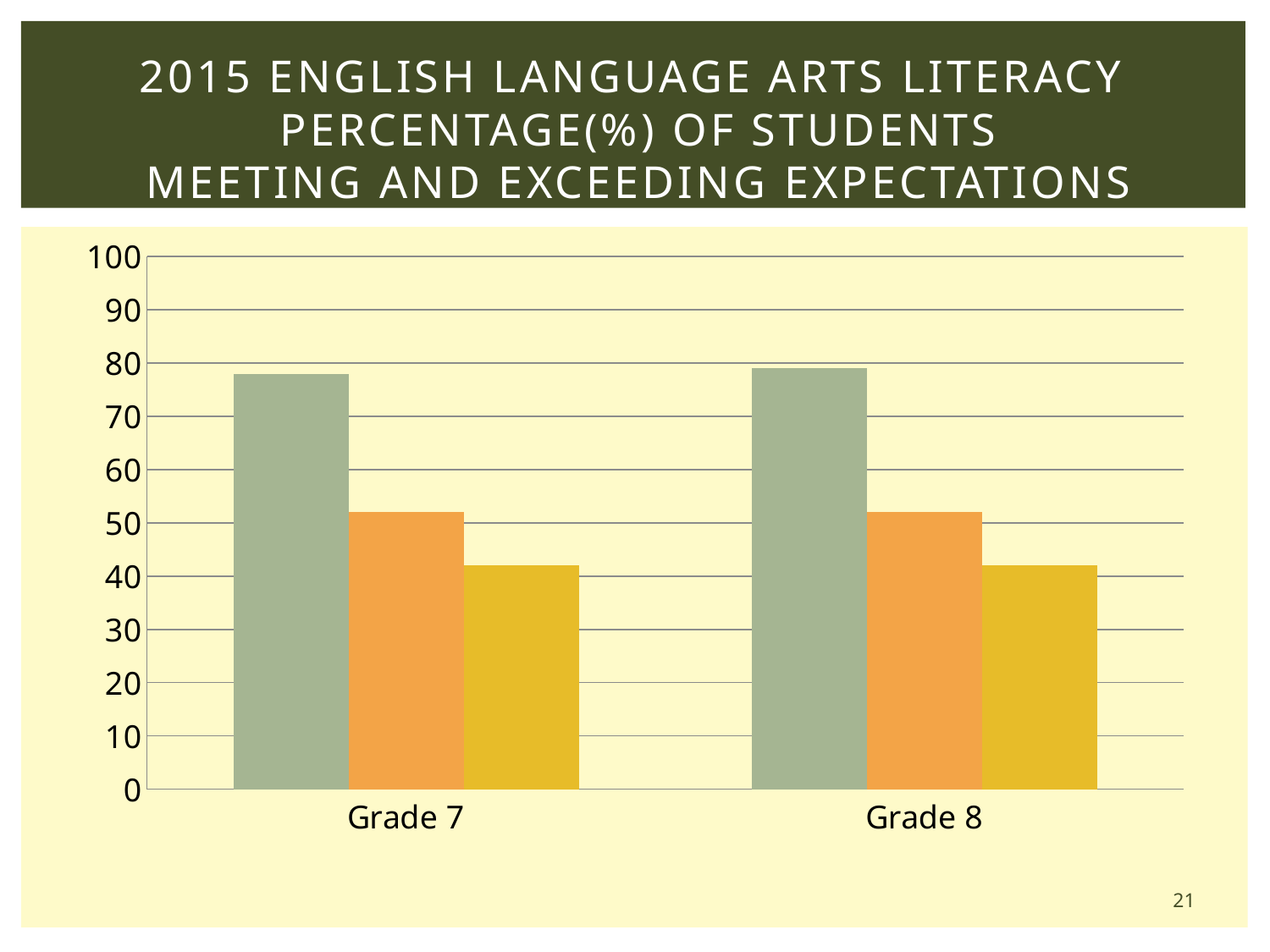
For Grade 7, which is larger: the orange bar or the yellow bar? the orange bar What is the highest value shown on the vertical axis? 100 Is the value of the green bar for Grade 7 greater or less than 70? greater Is the value of the orange bar for Grade 8 greater or less than 50? greater How many grade categories are shown on the x axis? 2 What kind of chart is shown on the slide? bar chart How many bars are plotted for each grade? 3 Which coloured bar is the shortest for Grade 8? the yellow bar Which coloured bar is the tallest for Grade 7? the green bar Is the value of the orange bar for Grade 7 greater or less than 60? less